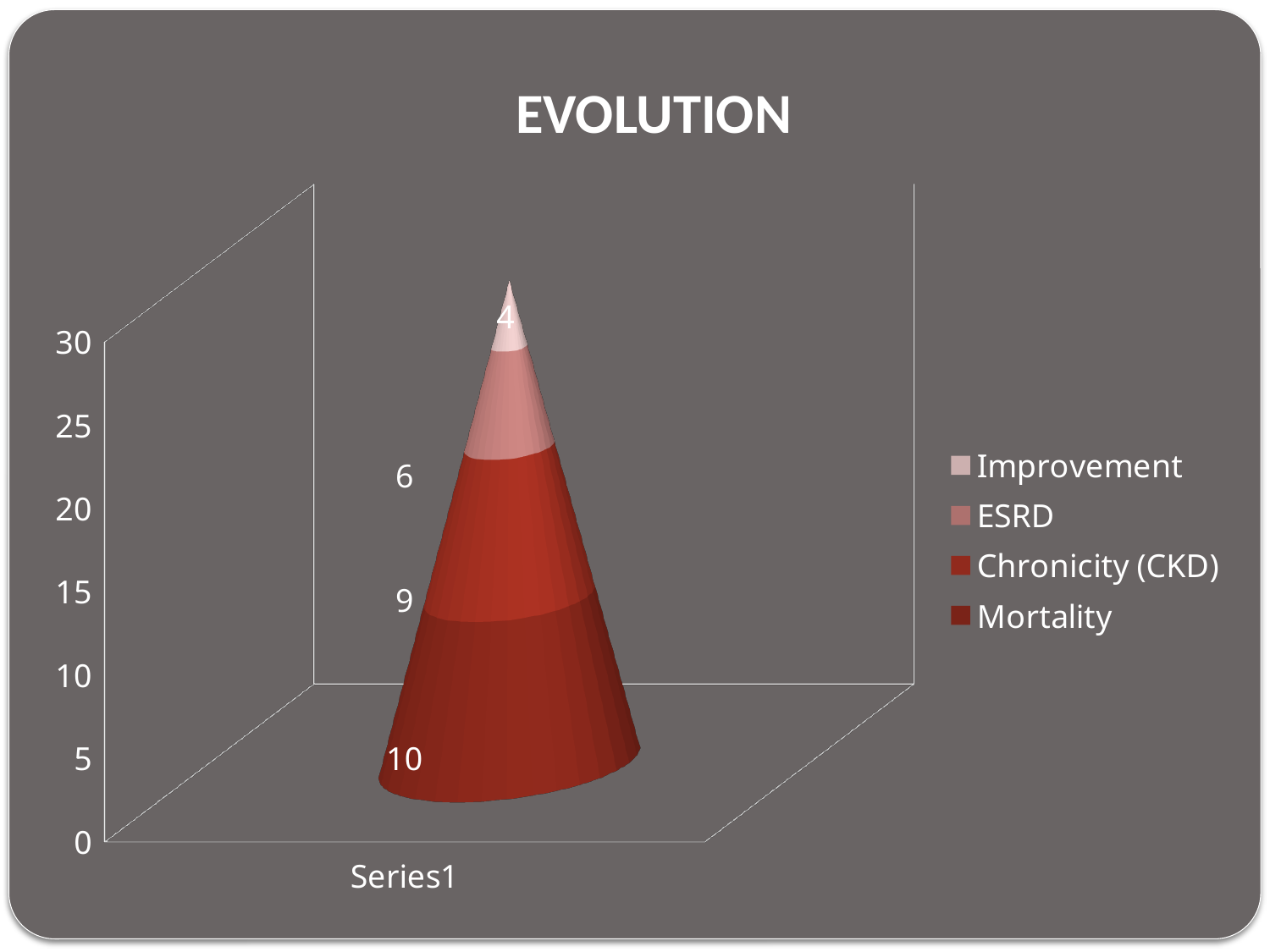
What is the value for Chronicity (CKD)? 9 What is the title of the chart? EVOLUTION Which is larger, the value for ESRD or the value for Chronicity (CKD)? Chronicity (CKD) Which series has the highest value? Mortality How many series does the legend list? 4 What is the value for Improvement? 4 What is the difference between the values for Mortality and Improvement? 6 Which series has the lowest value? Improvement What is the value for ESRD? 6 What is the difference between the values for Chronicity (CKD) and ESRD? 3 What is the total of the stacked bar for Series1? 29 What is the value for Mortality? 10